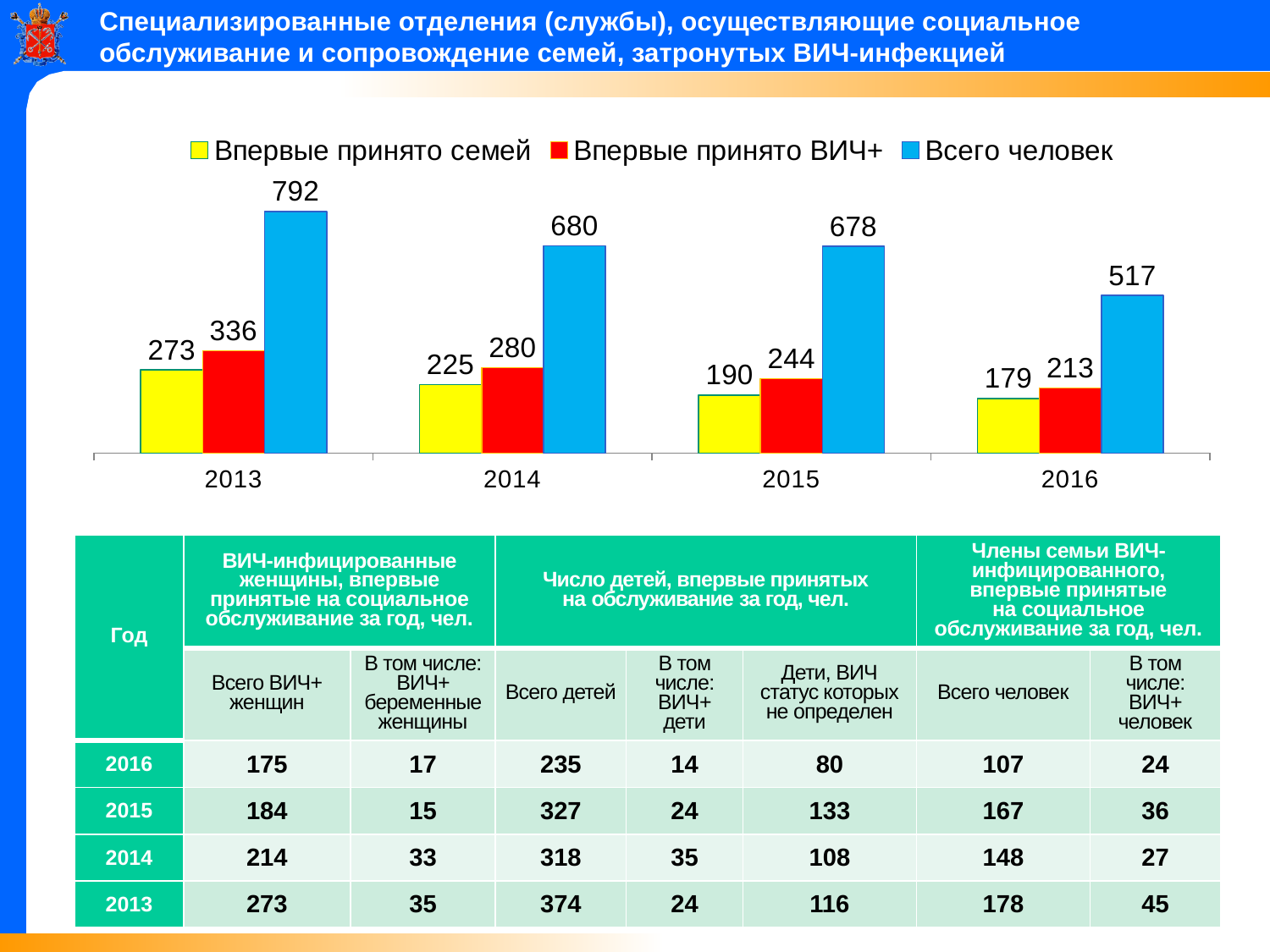
What is the value of "Впервые принято семей" for 2016? 179 Does the value of "Впервые принято семей" rise or fall from 2013 to 2016? Fall In which year is "Впервые принято семей" the lowest? 2016 What colour are the bars for "Всего человек"? Blue What is the difference between "Всего человек" in 2013 and in 2016? 275 What is the value of "Впервые принято ВИЧ+" for 2014? 280 How many years are shown on the x axis of the chart? 4 How many series does the chart legend list? 3 Which is larger: "Впервые принято ВИЧ+" in 2015 or "Впервые принято семей" in 2013? Впервые принято семей in 2013 What kind of chart is shown on the slide? Bar chart In which year is "Всего человек" the highest? 2013 What is the value of "Всего человек" for 2013? 792